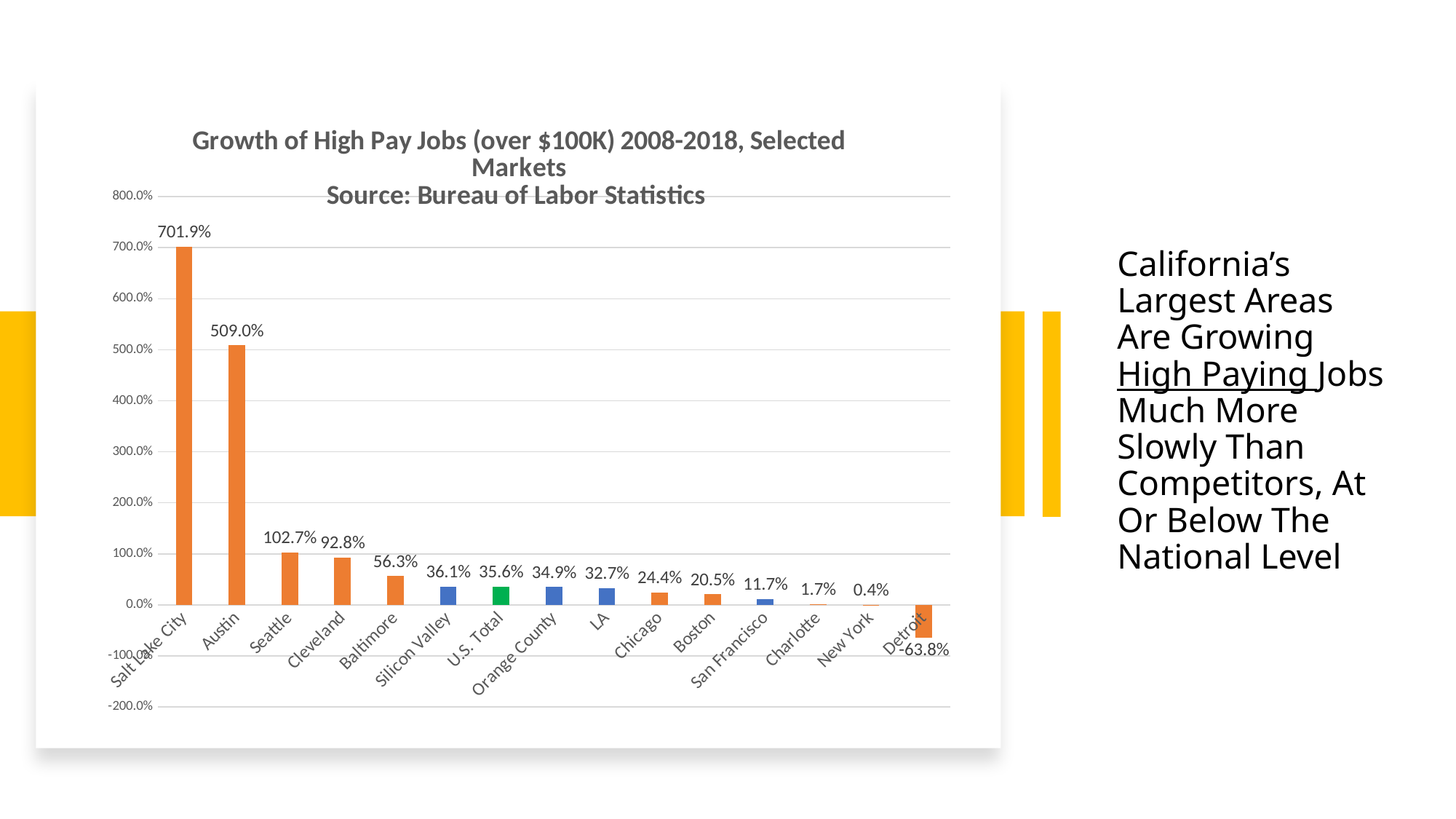
What colour is the U.S. Total bar? Green What kind of chart is this? Bar chart What is the difference between Salt Lake City and Austin? 192.9% What is the value for San Francisco? 11.7% What is the difference between Silicon Valley and U.S. Total? 0.5% What is the value for Salt Lake City? 701.9% Which market has the lowest growth? Detroit Which market has the highest growth? Salt Lake City What is the value for Detroit? -63.8% Which is larger, Seattle or Cleveland? Seattle How many markets are shown on the chart? 15 What is the value for U.S. Total? 35.6%